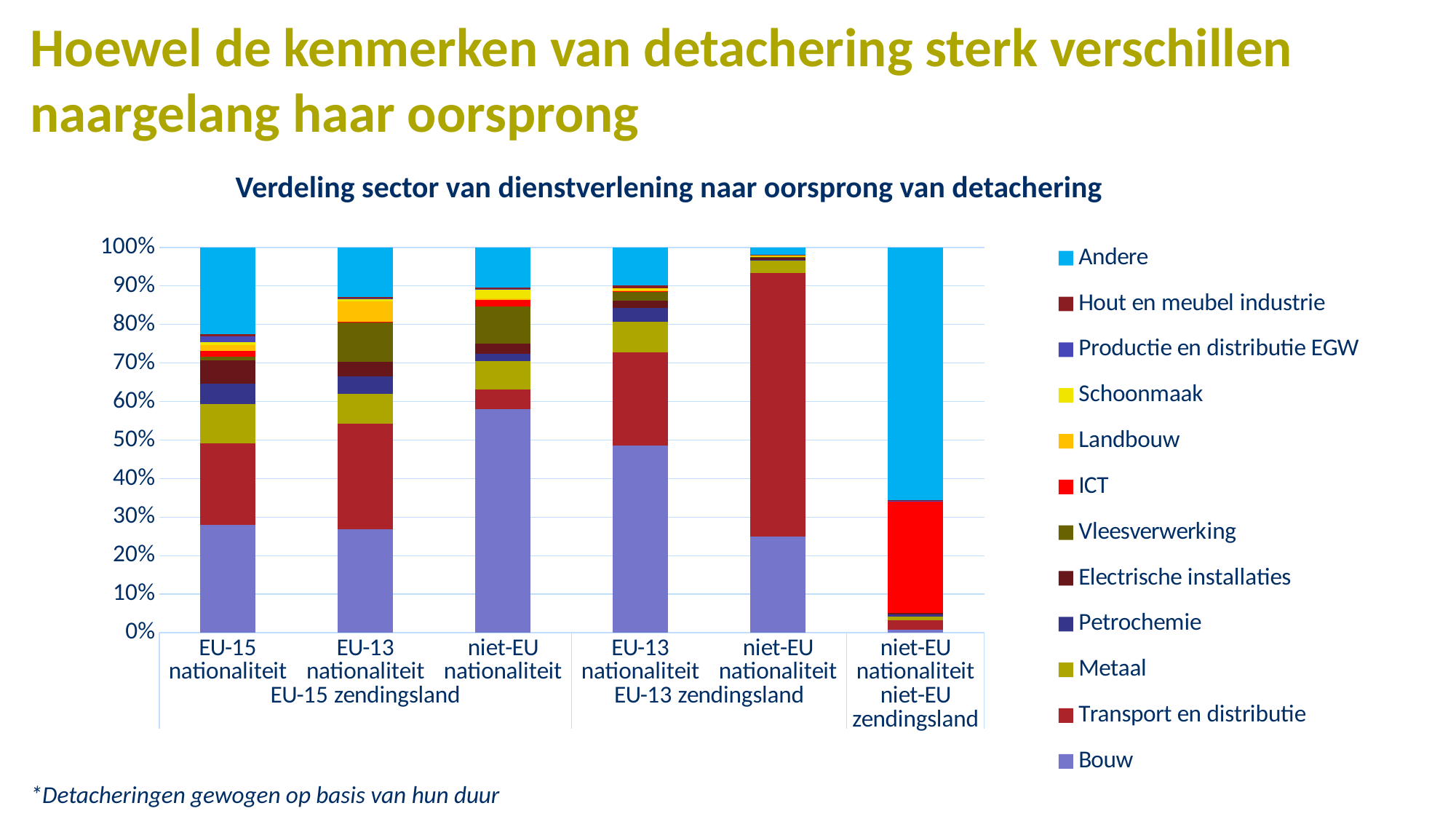
Is the Bouw share for niet-EU nationaliteit, EU-15 zendingsland greater or less than 50%? greater What is the title of the chart? Verdeling sector van dienstverlening naar oorsprong van detachering Which category has the largest Bouw share? niet-EU nationaliteit, EU-15 zendingsland Which category has the smallest Bouw share? niet-EU nationaliteit, niet-EU zendingsland Which category has the largest Andere share? niet-EU nationaliteit, niet-EU zendingsland Which has the larger Bouw share: EU-13 nationaliteit, EU-13 zendingsland or EU-15 nationaliteit, EU-15 zendingsland? EU-13 nationaliteit, EU-13 zendingsland Which category has the largest Transport en distributie share? niet-EU nationaliteit, EU-13 zendingsland How many bars (categories) are plotted in the chart? 6 What kind of chart is shown on the slide? Stacked bar chart Is the Bouw share for EU-15 nationaliteit, EU-15 zendingsland greater or less than 40%? less Which legend entry represents the bottom segment of each bar? Bouw How many series does the legend list? 12